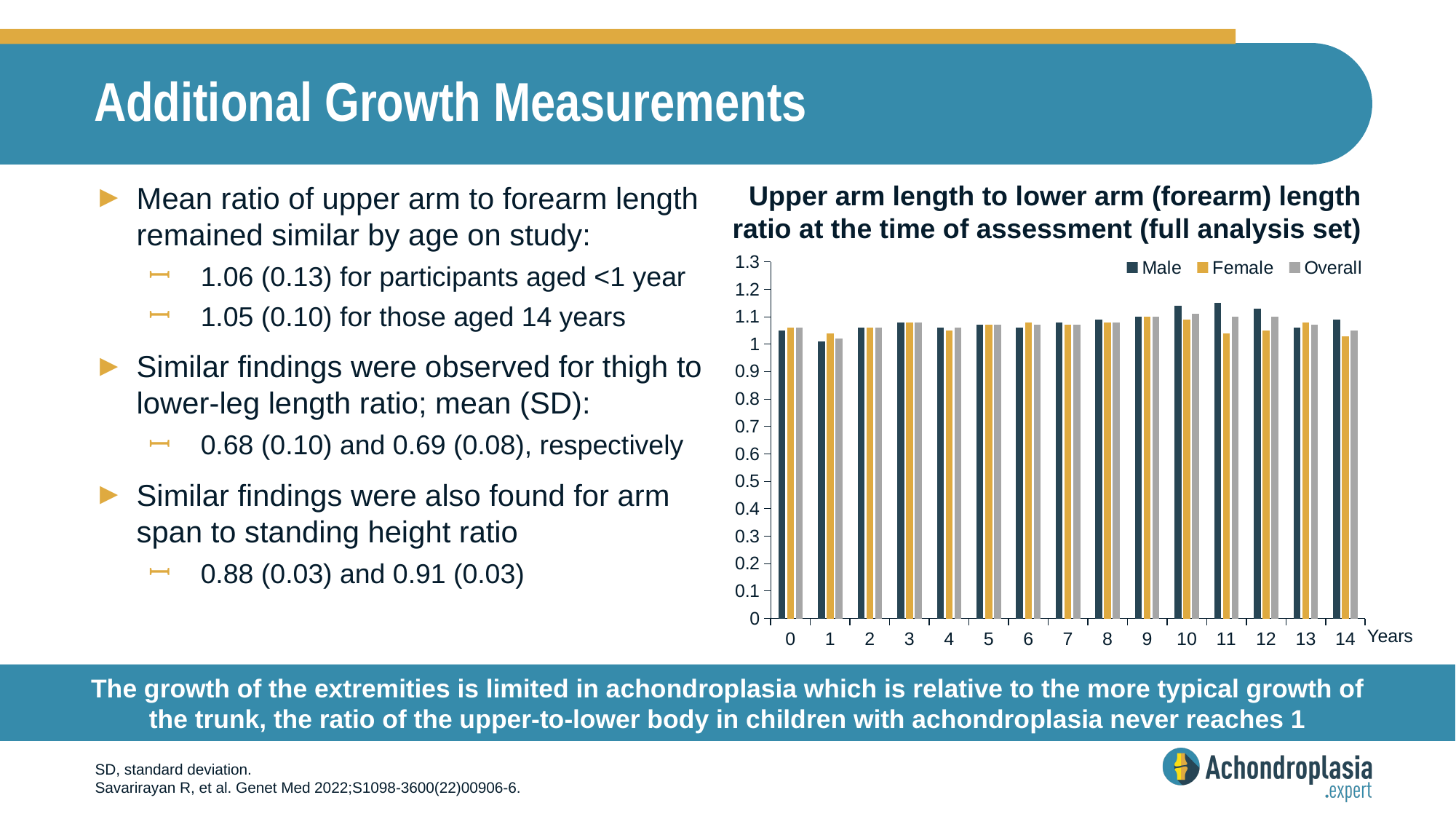
Is the Overall value at age 0 greater or less than 1.1? less At which age is the Overall value lowest? 1 At which age is the Male value lowest? 1 Is the Male value at age 11 greater or less than 1.1? greater How many series does the chart legend list? 3 Is the Male value at age 10 greater or less than 1.1? greater What is the label on the x axis of the chart? Years How many age categories are shown along the x axis of the chart? 15 What are the three series named in the chart legend? Male, Female, Overall What kind of chart is shown on the slide? bar chart At age 11, which is larger, the Male value or the Female value? Male